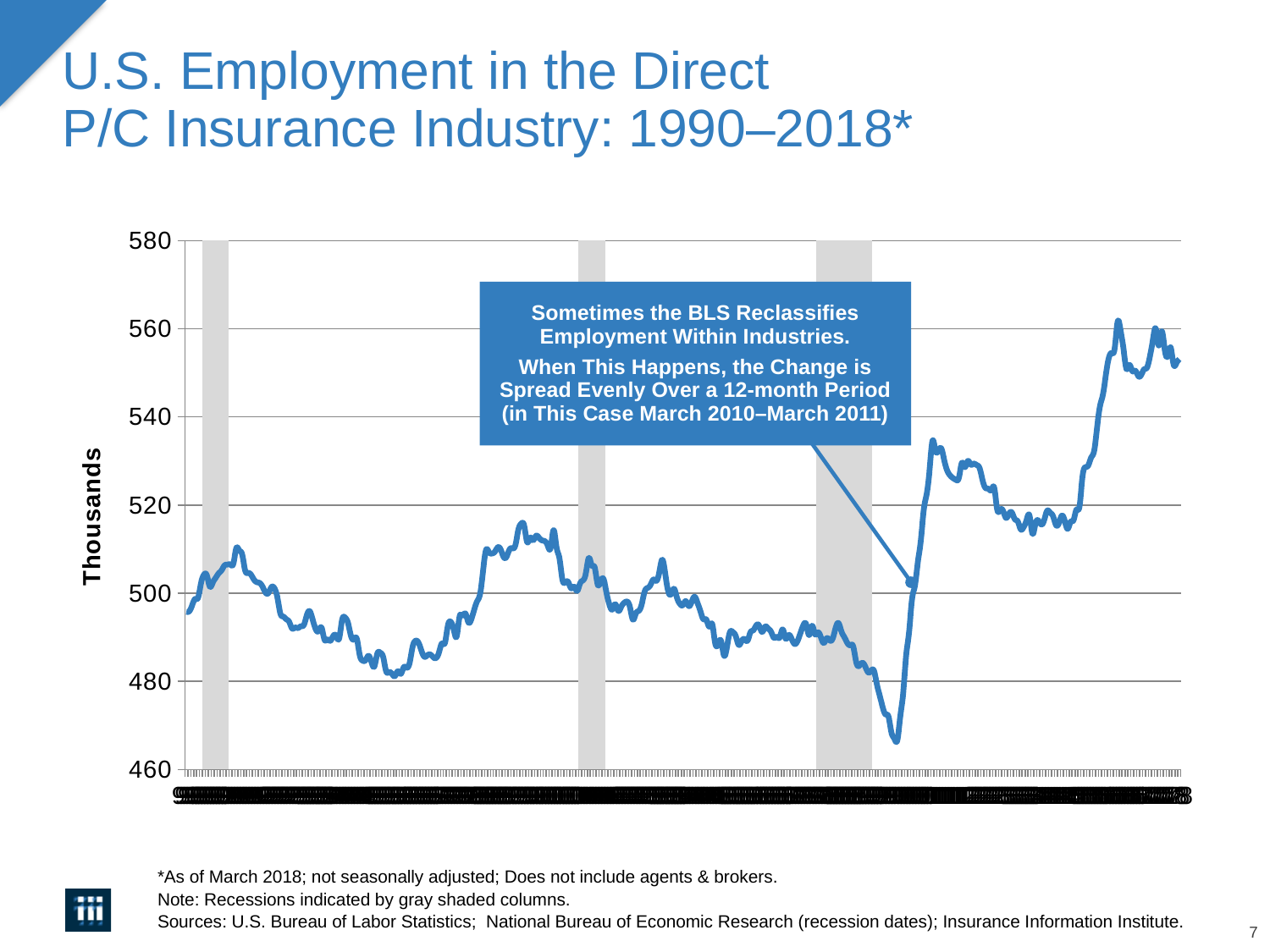
Is the value at the right end of the line (March 2018) greater or less than 540? greater Comparing the start of the line in 1990 with its end in 2018, does employment rise or fall overall? rise Is the lowest point of the line greater or less than 480? less What kind of chart is shown on the slide? line chart Is the highest point of the line greater or less than 540? greater What is the label on the vertical axis of the chart? Thousands What is the highest value shown on the vertical axis of the chart? 580 What is the lowest value shown on the vertical axis of the chart? 460 What do the gray shaded columns on the chart indicate? Recessions How many data series are plotted on the chart? 1 How many gray shaded recession columns appear on the chart? 3